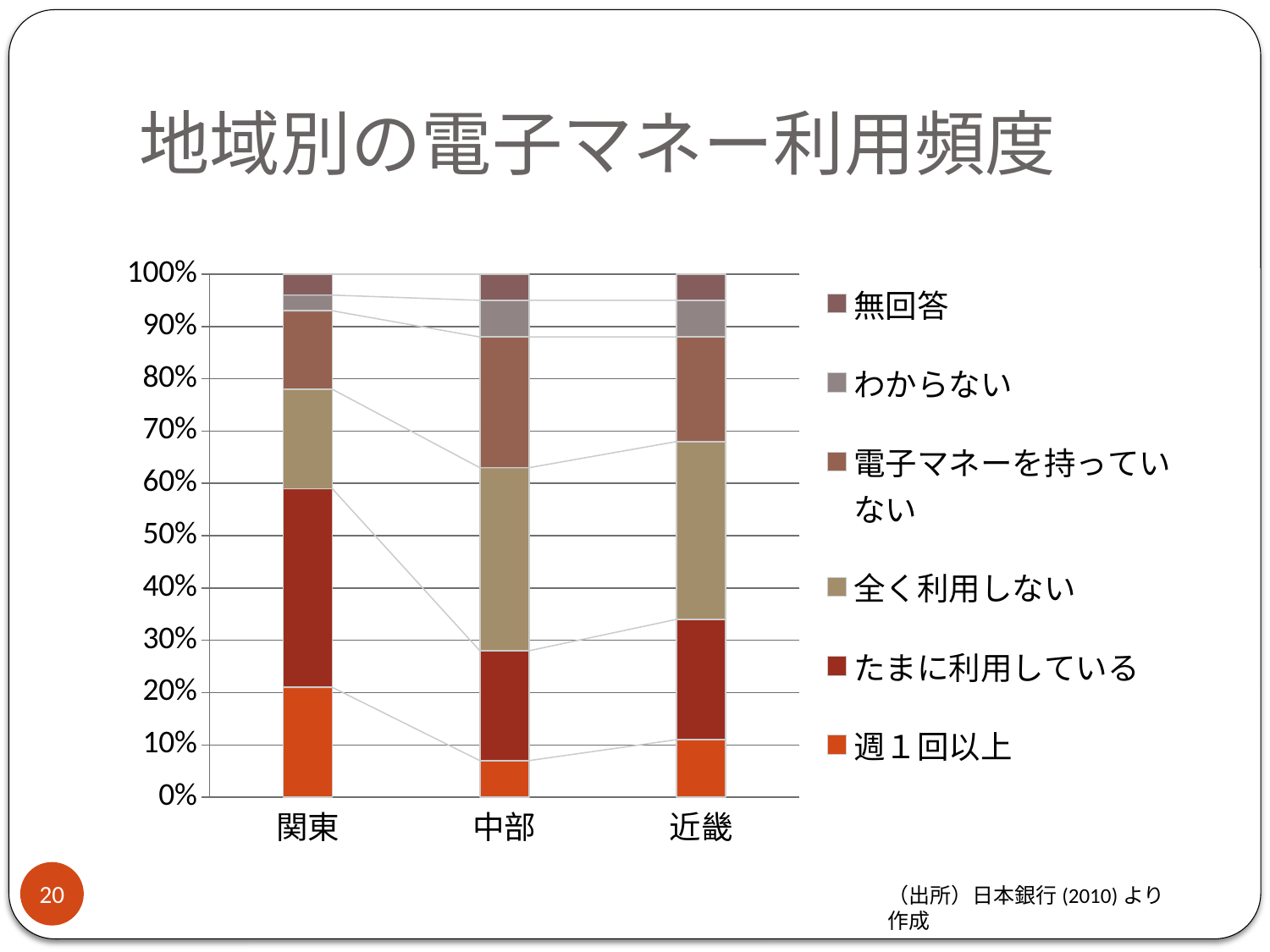
Which region has the smallest share for 全く利用しない? 関東 What kind of chart is shown on the slide? Stacked bar chart How many series does the legend list? 6 Which region has the smallest share for 週１回以上? 中部 Which legend entry is listed at the bottom of the legend? 週１回以上 How many regions are shown on the x axis of the chart? 3 What is the title of the chart? 地域別の電子マネー利用頻度 Is the 週１回以上 share for 関東 greater or less than 10%? greater Which region has the largest share for たまに利用している? 関東 Is the 週１回以上 share for 中部 greater or less than 10%? less Which is larger: the 電子マネーを持っていない share for 中部 or for 関東? 中部 Which region has the largest share for 週１回以上? 関東